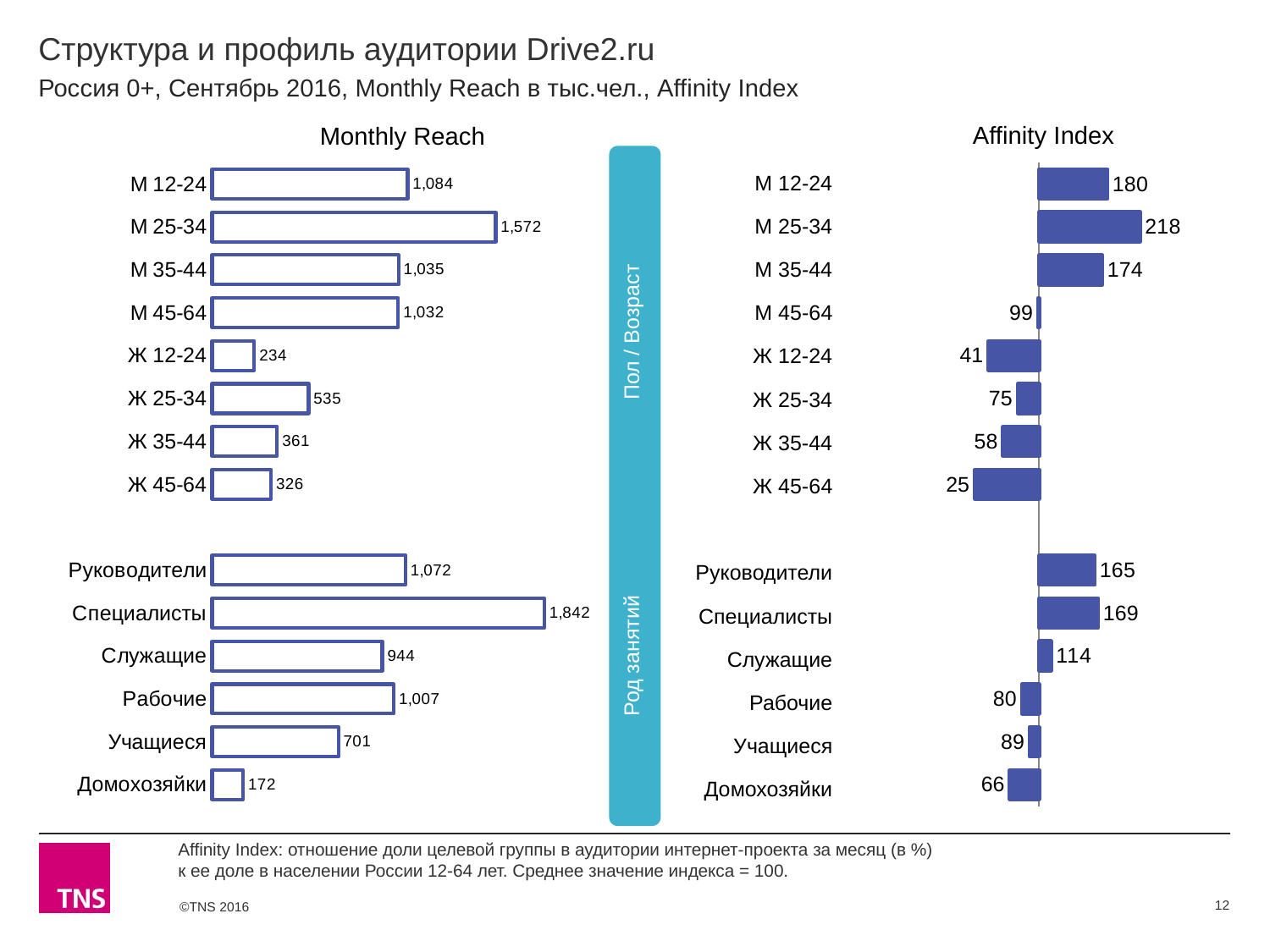
In the Monthly Reach chart, which category has the highest value? Специалисты In the Affinity Index chart, what is the value for Ж 45-64? 25 In the Affinity Index chart, what is the difference between М 12-24 and Ж 12-24? 139 In the Affinity Index chart, which is larger: Учащиеся or Рабочие? Учащиеся In the Affinity Index chart, which category has the highest value? М 25-34 In the Affinity Index chart, which category has the lowest value? Ж 45-64 In the Monthly Reach chart, what is the value for М 25-34? 1,572 How many categories are plotted in the Affinity Index chart? 14 In the Monthly Reach chart, which is larger: Рабочие or Служащие? Рабочие What kind of chart is the Monthly Reach chart? Bar chart In the Monthly Reach chart, what is the difference between Специалисты and Руководители? 770 In the Monthly Reach chart, which category has the lowest value? Домохозяйки